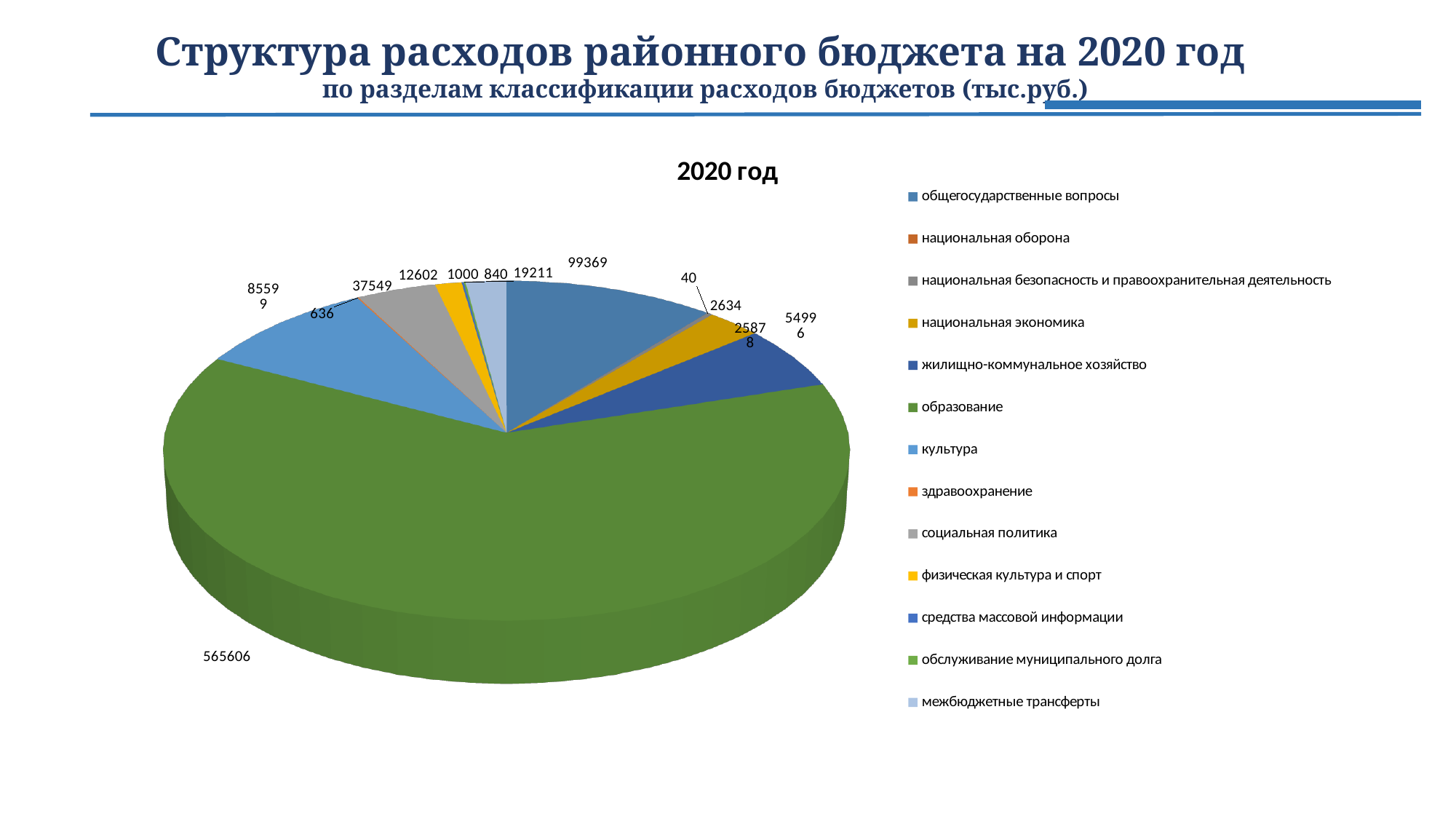
What is the value for физическая культура и спорт? 12602 What is the value for общегосударственные вопросы? 99369 Which is larger: общегосударственные вопросы or социальная политика? общегосударственные вопросы How many categories does the legend list? 13 Which category has the smallest value in the pie chart? национальная оборона What is the value for социальная политика? 37549 What is the value for национальная оборона? 40 What is the value for образование? 565606 What is the value for межбюджетные трансферты? 19211 What is the difference between the values for общегосударственные вопросы and социальная политика? 61820 Which category has the largest slice in the pie chart? образование What kind of chart is shown on the slide? pie chart